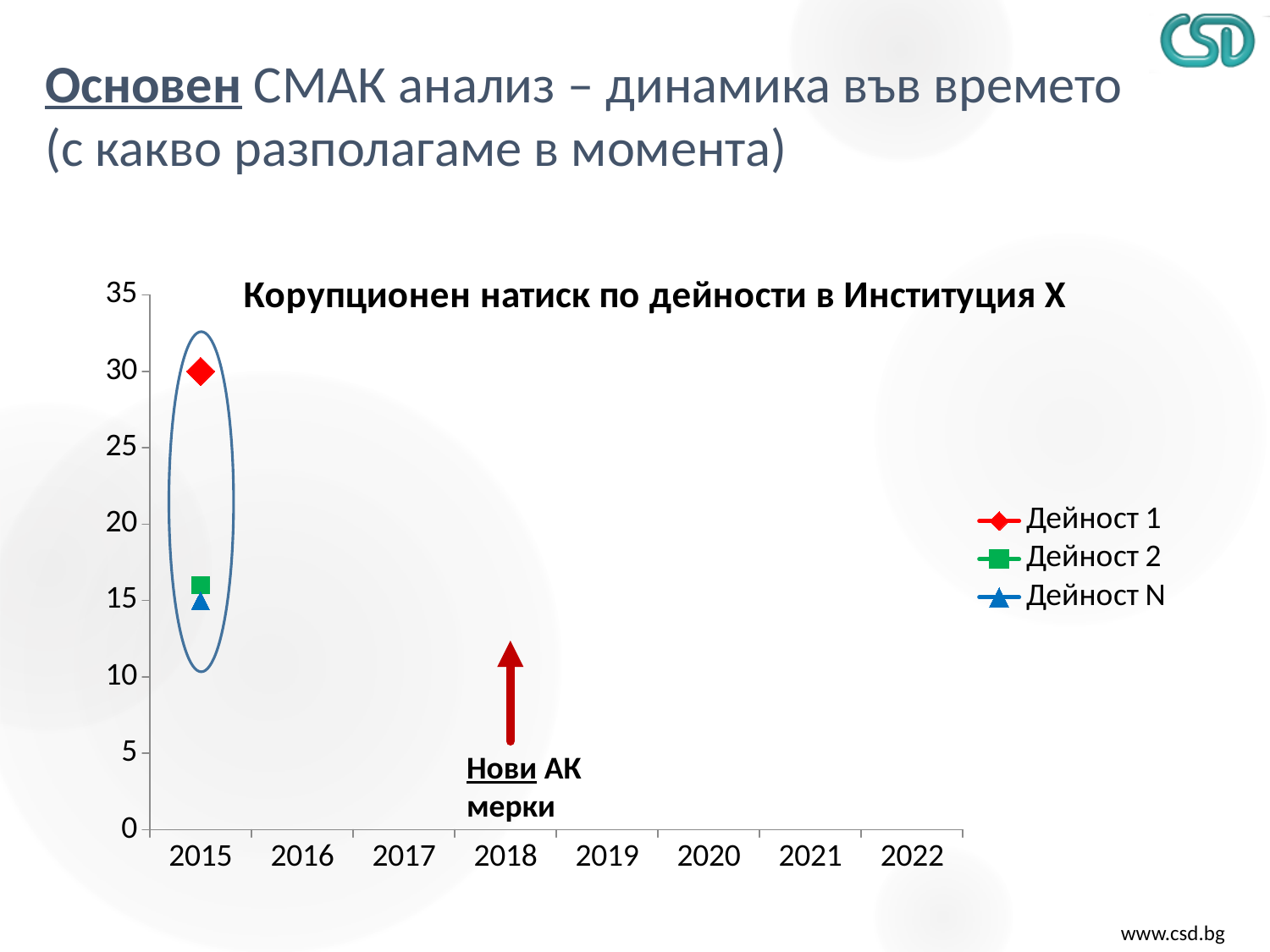
Is the value for Дейност 2 in 2015 greater or less than 20? less What is the value for Дейност 1 in 2015? 30 Is the value for Дейност 1 in 2015 greater or less than 25? greater How many series does the chart legend list? 3 Which is larger in 2015, the value for Дейност 1 or the value for Дейност 2? Дейност 1 How many years are shown on the x axis of the chart? 8 What is the value for Дейност N in 2015? 15 What is the difference between the 2015 values for Дейност 1 and Дейност N? 15 What is the title of the chart? Корупционен натиск по дейности в Институция Х What kind of chart is shown on the slide? line chart Which series has the highest value in 2015? Дейност 1 Which year on the x axis is marked with the annotation 'Нови АК мерки'? 2018